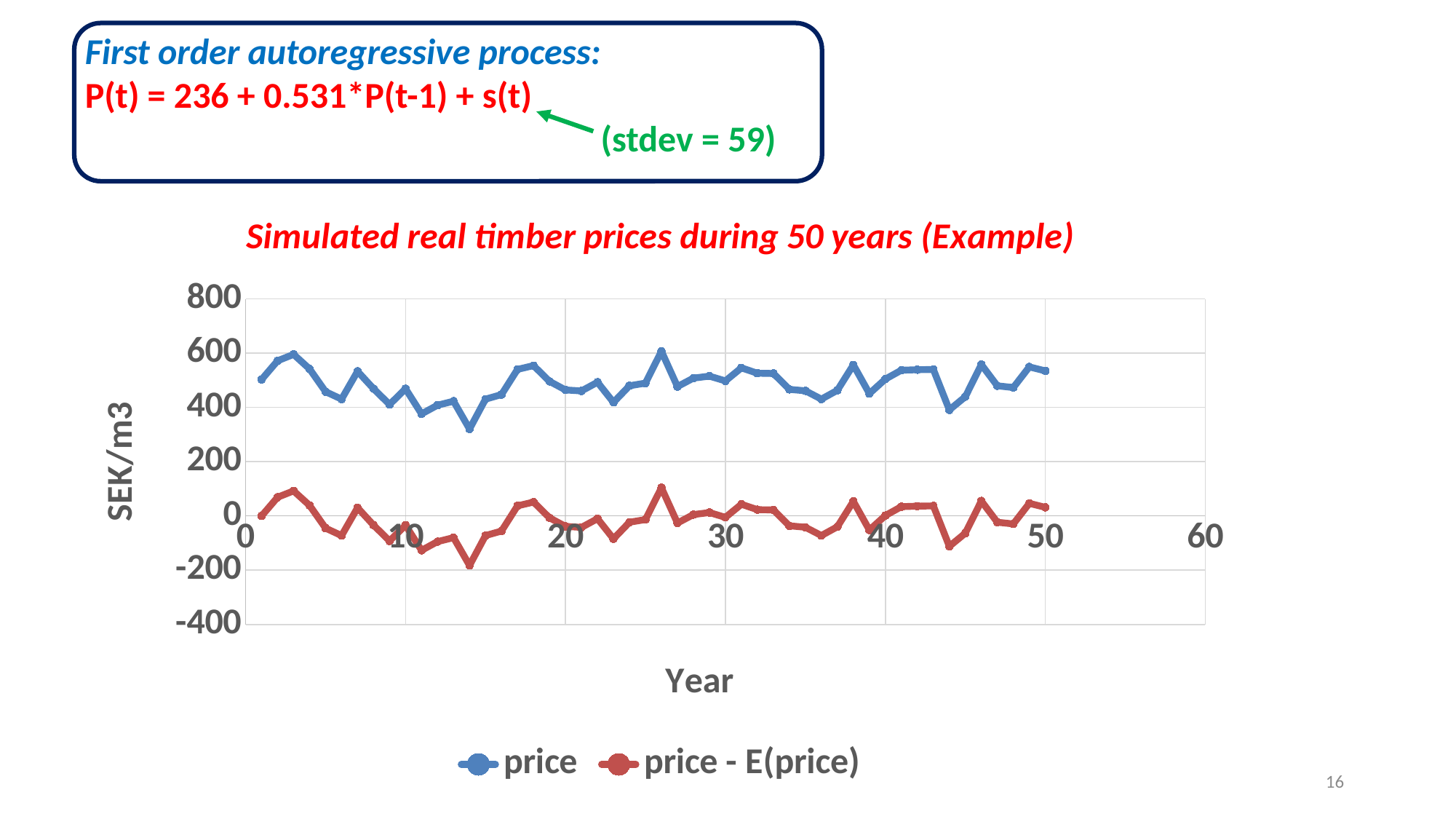
Is the price value at year 1 greater or less than 400? greater Is the price - E(price) value at year 50 greater or less than 200? less Which series lies higher on the chart, price or price - E(price)? price What are the two series named in the legend? price and price - E(price) How many series does the legend list? 2 Is the lowest point of the price series greater or less than 200? greater What kind of chart is shown on the slide? line chart How many years of data are plotted for each series? 50 Does the price series show a steady upward trend, a steady downward trend, or fluctuation around a roughly constant level across the years? fluctuation around a roughly constant level What is the title of the chart? Simulated real timber prices during 50 years (Example)